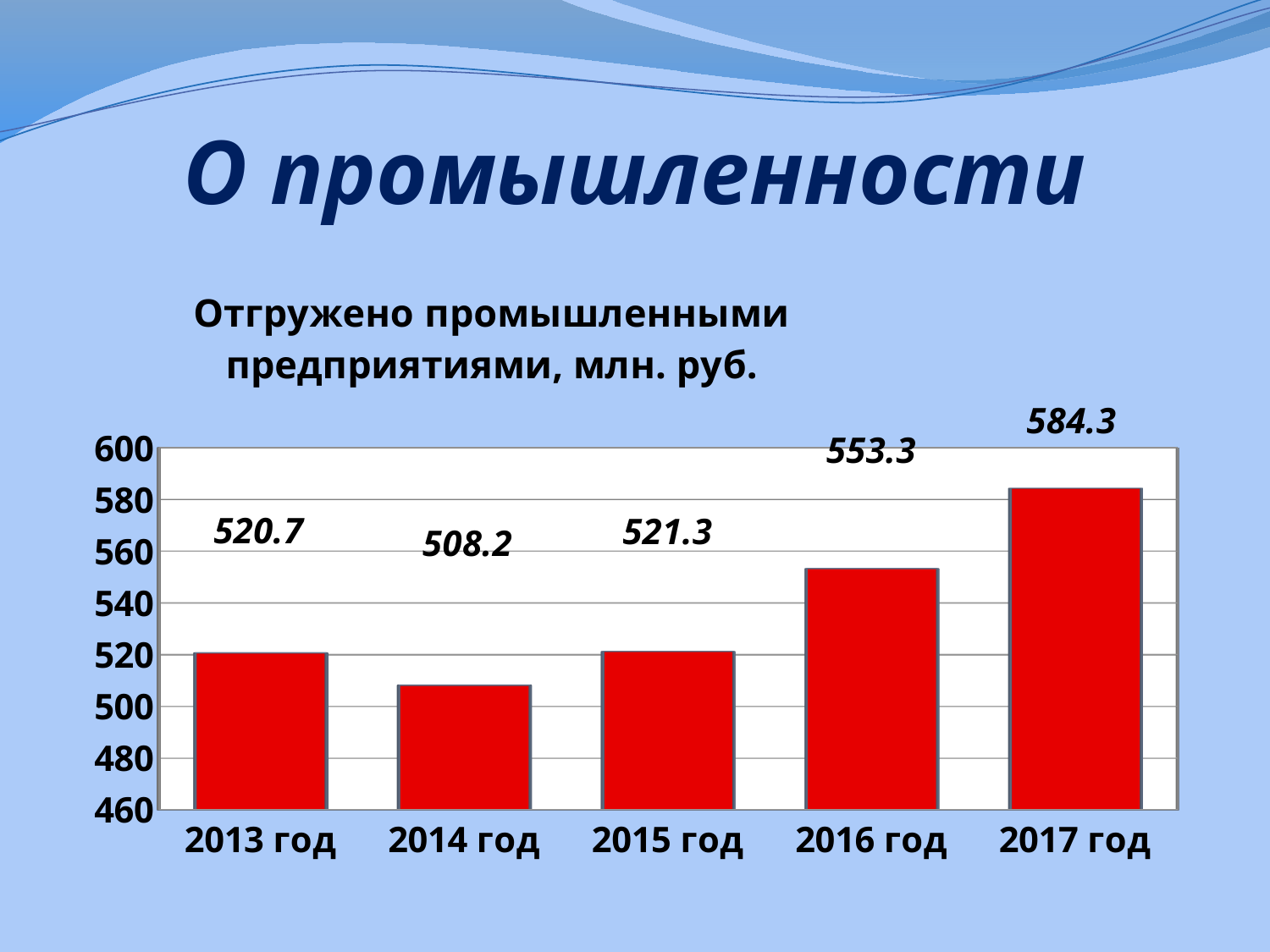
What is the title of the chart? Отгружено промышленными предприятиями, млн. руб. What is the difference between the values for 2017 год and 2016 год? 31.0 What is the value for 2016 год? 553.3 What is the value for 2013 год? 520.7 Which year has the highest value? 2017 год Which is larger, the value for 2015 год or the value for 2013 год? 2015 год What is the difference between the values for 2013 год and 2014 год? 12.5 How many years are shown on the chart? 5 Is the value for 2016 год greater or less than 540? greater Do the values rise or fall from 2014 год to 2017 год? rise What kind of chart is shown on the slide? bar chart Which year has the lowest value? 2014 год